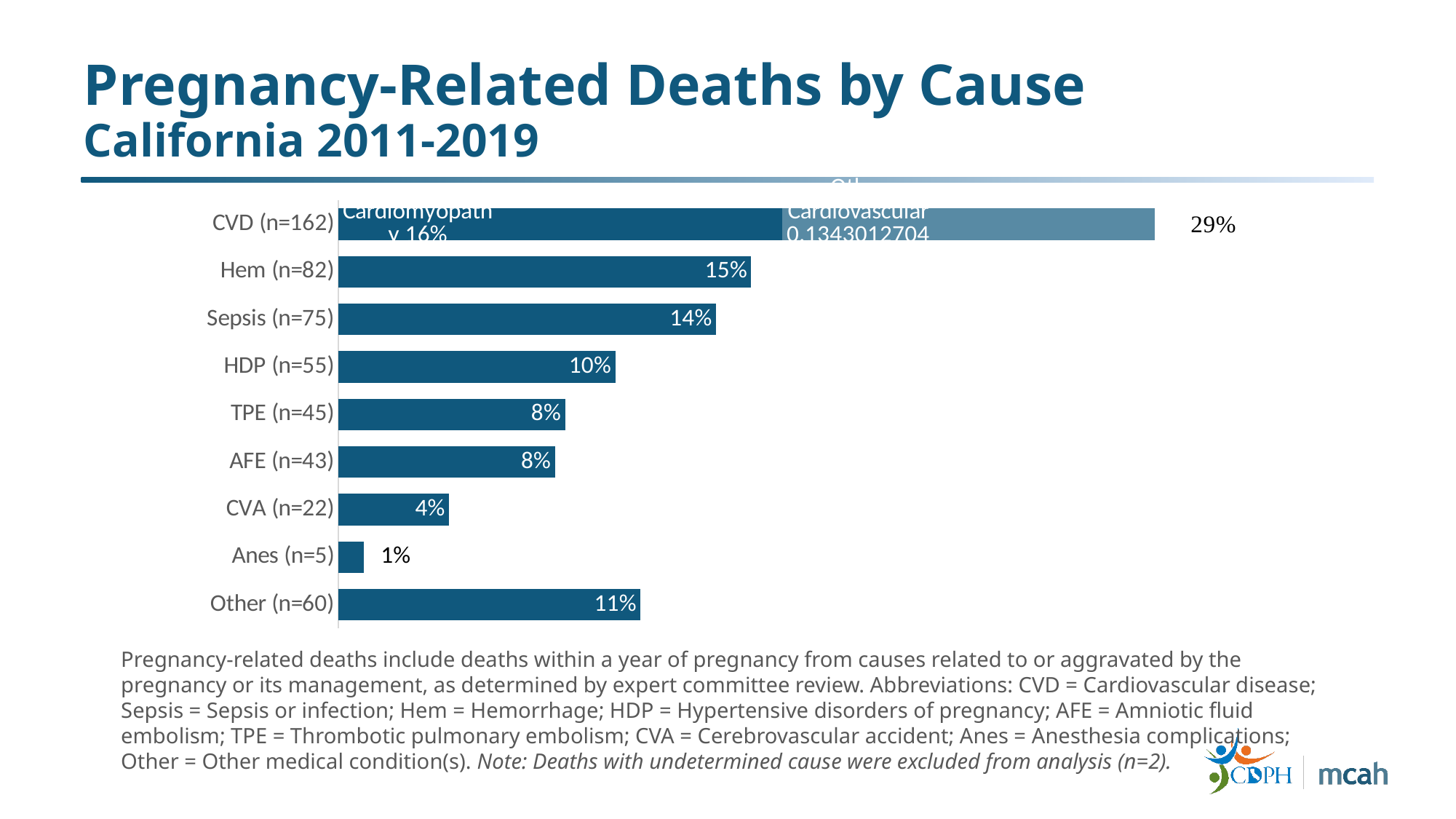
What is the total percentage shown at the end of the CVD (n=162) bar? 29% What percentage of pregnancy-related deaths is shown for Hem (n=82)? 15% What percentage is shown for HDP (n=55)? 10% Which cause has the highest percentage of pregnancy-related deaths? CVD (n=162) What percentage is shown for Sepsis (n=75)? 14% Which cause has the lowest percentage of pregnancy-related deaths? Anes (n=5) What is the percentage labeled for the Cardiomyopathy segment of the CVD bar? 16% Which has a larger percentage, Sepsis (n=75) or HDP (n=55)? Sepsis (n=75) What percentage is shown for Other (n=60)? 11% How many cause categories are shown on the chart? 9 What kind of chart is shown on the slide? bar chart What is the difference in percentage points between Hem (n=82) and CVA (n=22)? 11